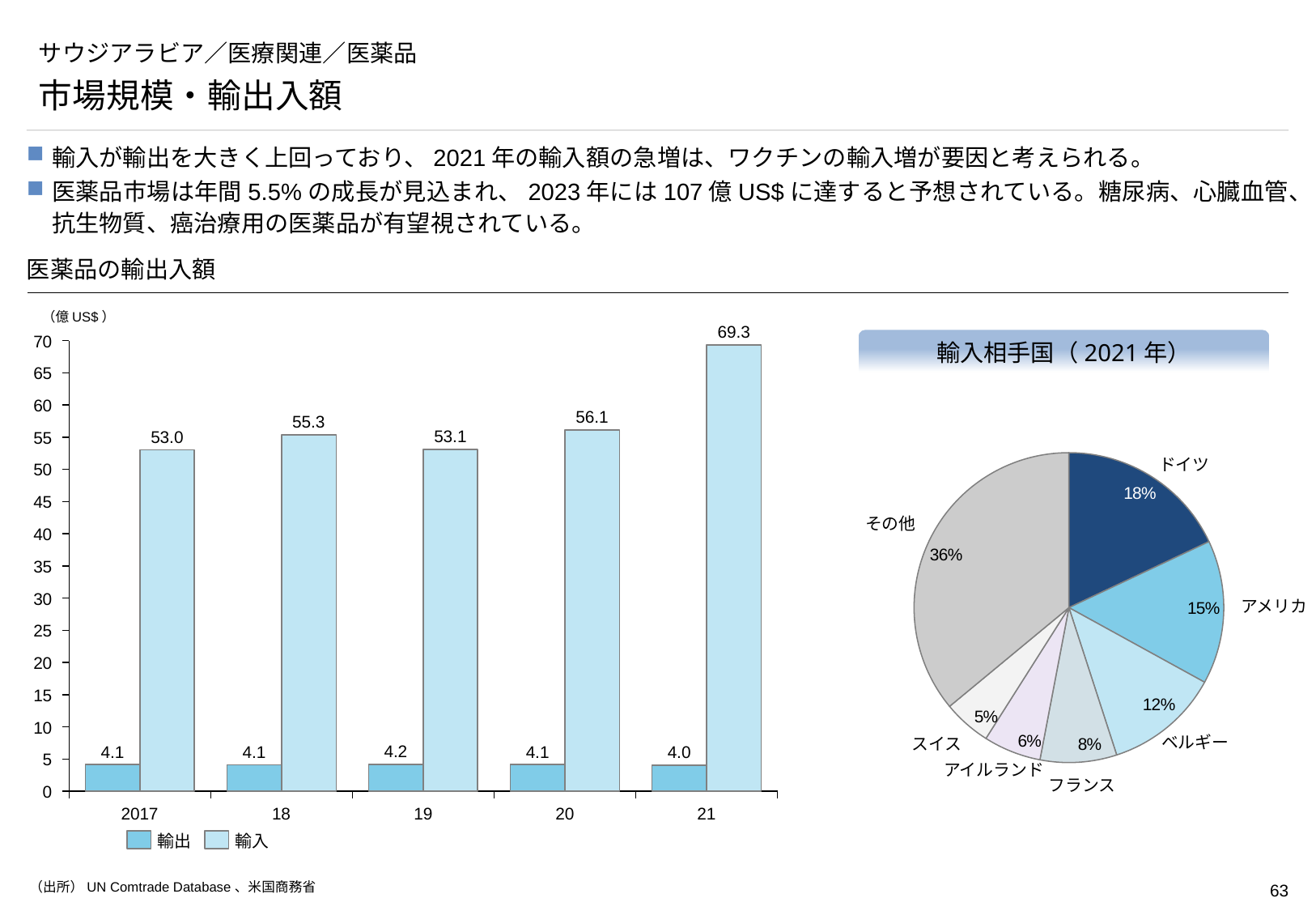
In the bar chart 医薬品の輸出入額, what is the 輸出 value for 19? 4.2 In the bar chart 医薬品の輸出入額, which year has the highest 輸入 value? 21 In the bar chart 医薬品の輸出入額, which is larger, the 輸入 value for 18 or for 19? 18 In the bar chart 医薬品の輸出入額, how many series does the legend list? 2 In the pie chart 輸入相手国 (2021年), which named country (excluding その他) has the smallest share? スイス In the bar chart 医薬品の輸出入額, which year has the lowest 輸出 value? 21 In the pie chart 輸入相手国 (2021年), what share does ドイツ have? 18% What kind of chart is 医薬品の輸出入額? bar chart In the bar chart 医薬品の輸出入額, how many years are shown on the x axis? 5 In the bar chart 医薬品の輸出入額, what is the 輸入 value for 21? 69.3 In the bar chart 医薬品の輸出入額, what is the difference between the 輸入 values for 21 and 20? 13.2 In the pie chart 輸入相手国 (2021年), how many slices are there? 7